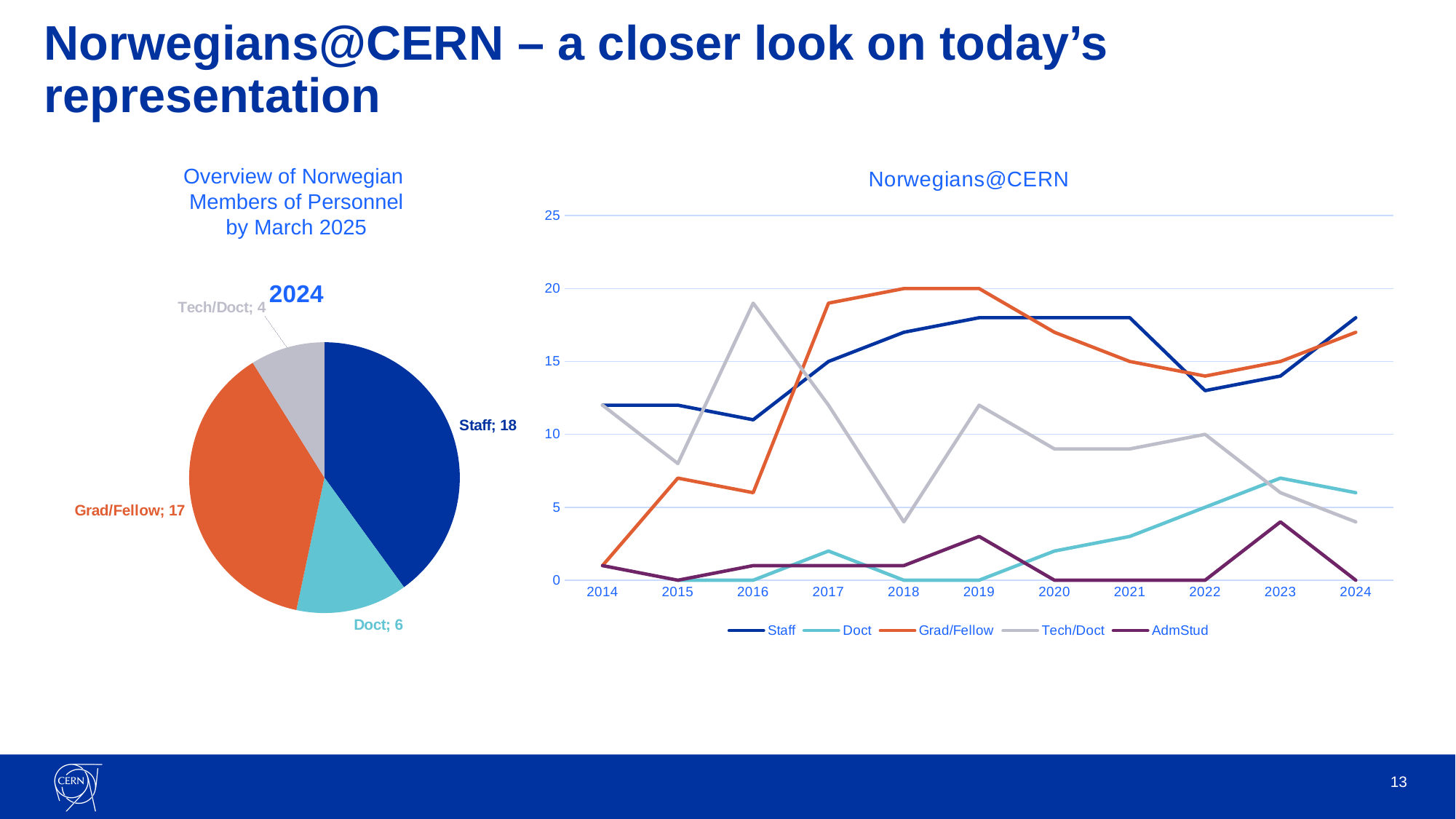
In the pie chart on the left, which category has the smallest slice? Tech/Doct What kind of chart is the Norwegians@CERN chart on the right? Line chart In the Norwegians@CERN line chart, which series has the highest value in 2016? Tech/Doct In the pie chart on the left, what is the value for Grad/Fellow? 17 In the pie chart on the left, what is the difference between the Doct and Tech/Doct values? 2 In the pie chart on the left, how many Staff members are shown? 18 In the pie chart on the left, what share of the total does the Staff slice represent? 40% In the pie chart on the left, what is the total of all four slices? 45 How many series does the legend of the Norwegians@CERN line chart list? 5 In the pie chart on the left, which category has the largest slice? Staff In the Norwegians@CERN line chart, how many years are shown on the x axis? 11 In the Norwegians@CERN line chart, is the Grad/Fellow value for 2017 greater or less than 15? greater